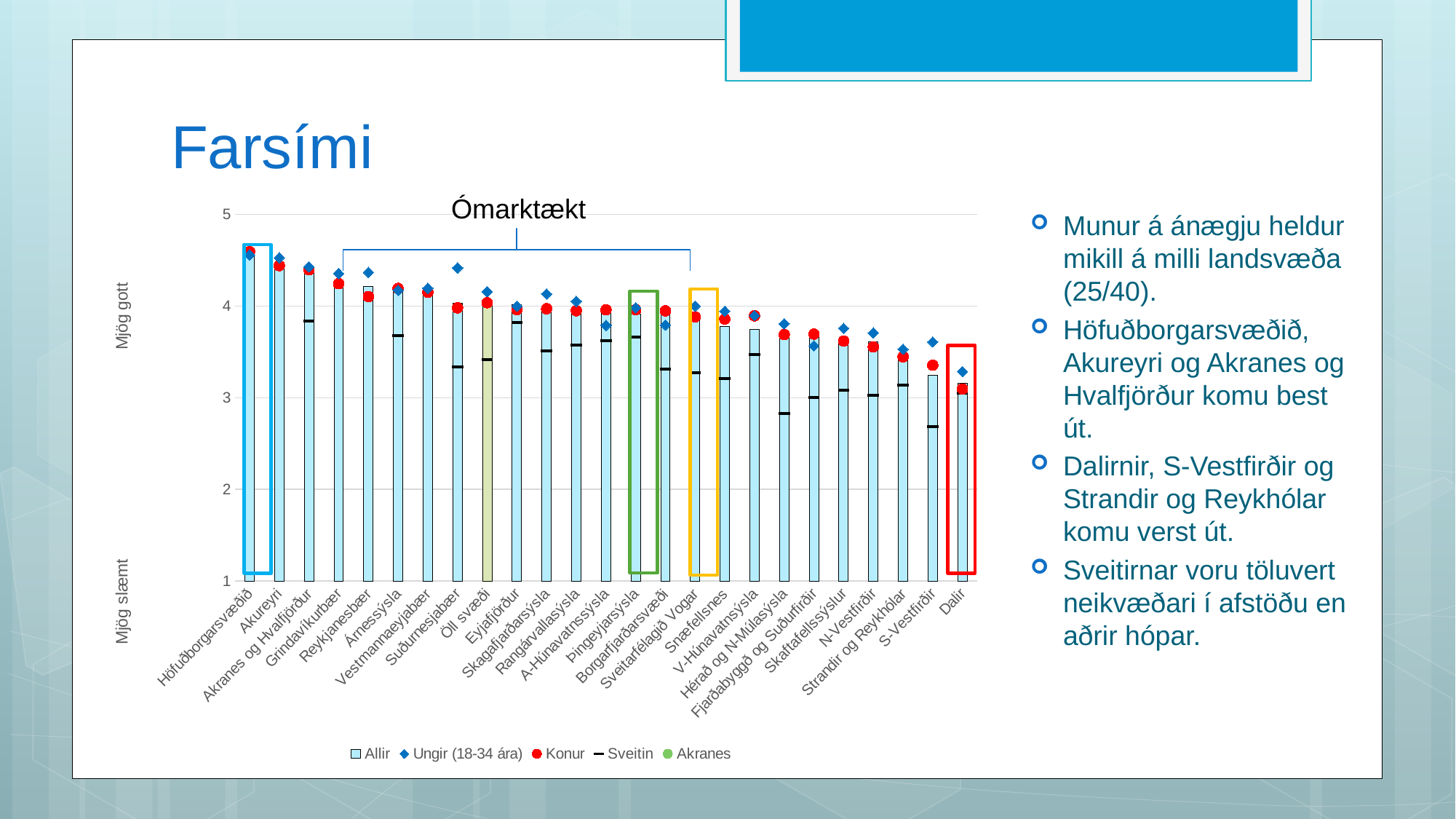
What is the title of the slide containing the chart? Farsími Is the 'Sveitin' value for S-Vestfirðir greater or less than 3? less How many series does the chart's legend list? 5 What annotation text is written above the bracketed group of bars in the chart? Ómarktækt Which region has the highest 'Allir' bar in the chart? Höfuðborgarsvæðið How many categories (regions) are plotted along the x axis of the chart? 25 What kind of chart is shown on the slide? Bar chart Do the 'Allir' bar values generally rise or fall from left to right along the x axis? fall Which region has the lowest 'Allir' bar in the chart? Dalir Which has the larger 'Allir' value, Akureyri or Dalir? Akureyri Is the 'Allir' value for Dalir greater or less than 4? less Is the 'Allir' value for Höfuðborgarsvæðið greater or less than 4? greater